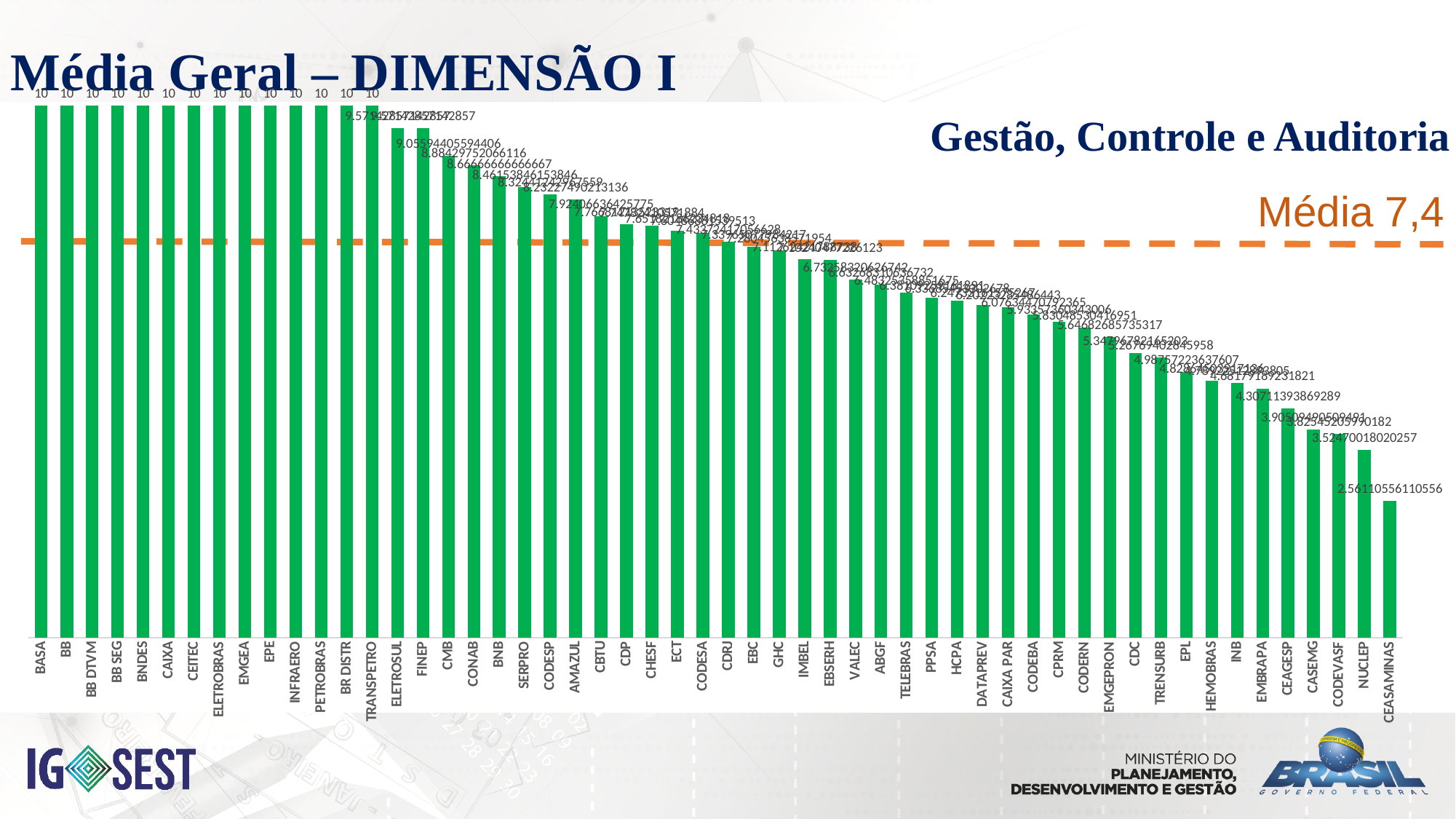
Which category has the lowest value? CEASAMINAS Which is larger, the value for CMB or the value for CEAGESP? CMB What is the value for BASA? 10 What is the highest value shown in the chart? 10 What is the value for CEASAMINAS? 2.56110556110556 What is the value for CMB? 9.05594405594406 What is the value for CBTU? 7.92406636425775 How many bars have a value of 10? 14 Do the bar values rise or fall from left to right along the x axis? fall What value does the dashed horizontal line represent? Média 7,4 What type of chart is shown on the slide? bar chart Is the value for CEASAMINAS greater or less than the Média line of 7,4? less